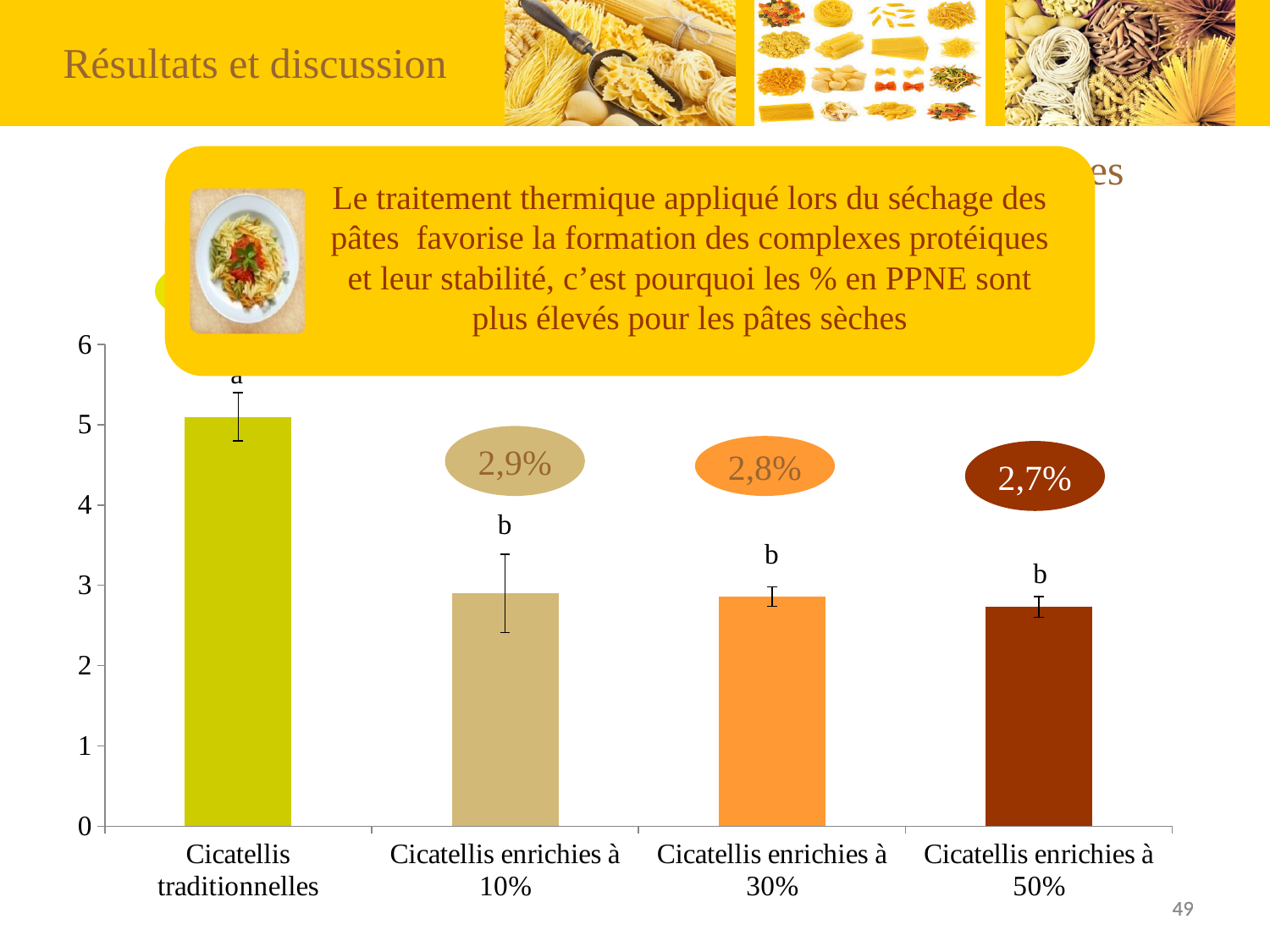
What is the value shown for Cicatellis enrichies à 10%? 2,9% What is the difference between the values for Cicatellis enrichies à 10% and Cicatellis enrichies à 50%? 0,2% Which category has the highest bar? Cicatellis traditionnelles What is the value shown for Cicatellis enrichies à 50%? 2,7% Do the bar values rise or fall from left to right along the x axis? fall Which is larger, the value for Cicatellis enrichies à 10% or for Cicatellis enrichies à 50%? Cicatellis enrichies à 10% What kind of chart is shown on the slide? bar chart Is the value for Cicatellis traditionnelles greater or less than 4? greater How many categories are shown on the x axis? 4 What is the value shown for Cicatellis enrichies à 30%? 2,8% Which category has the lowest labelled value? Cicatellis enrichies à 50% Is the value for Cicatellis enrichies à 30% greater or less than 4? less